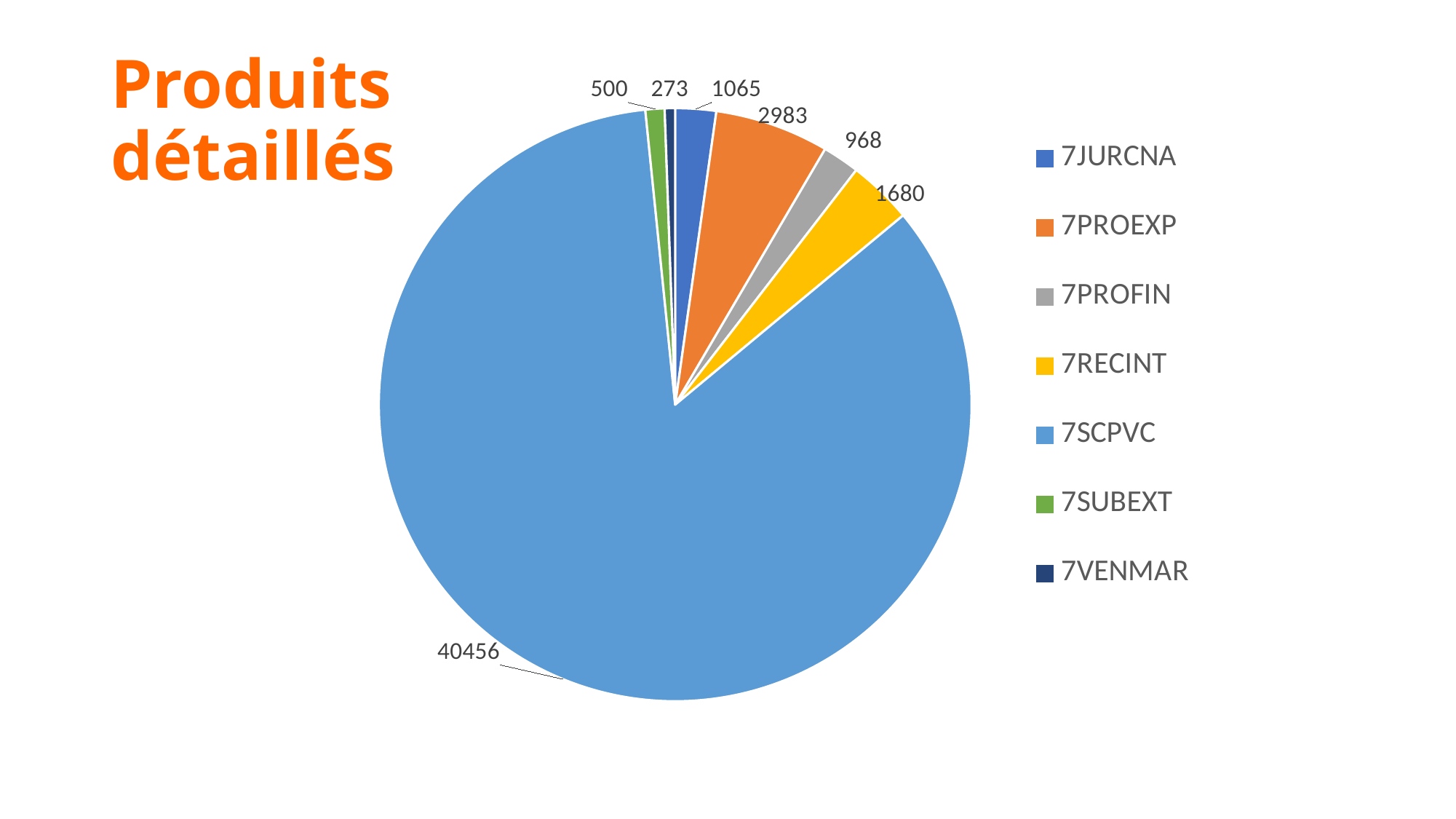
What is the value for 7SCPVC? 40456 What is the difference between the values for 7PROEXP and 7RECINT? 1303 Which is larger, the value for 7JURCNA or the value for 7PROFIN? 7JURCNA What is the value for 7PROEXP? 2983 How many categories does the pie chart have? 7 What is the value for 7VENMAR? 273 What is the value for 7RECINT? 1680 What type of chart is shown on the slide? pie chart Which category has the largest slice of the pie? 7SCPVC Which category has the smallest slice of the pie? 7VENMAR What is the title of the slide? Produits détaillés What is the total of all the values shown in the pie chart? 47925